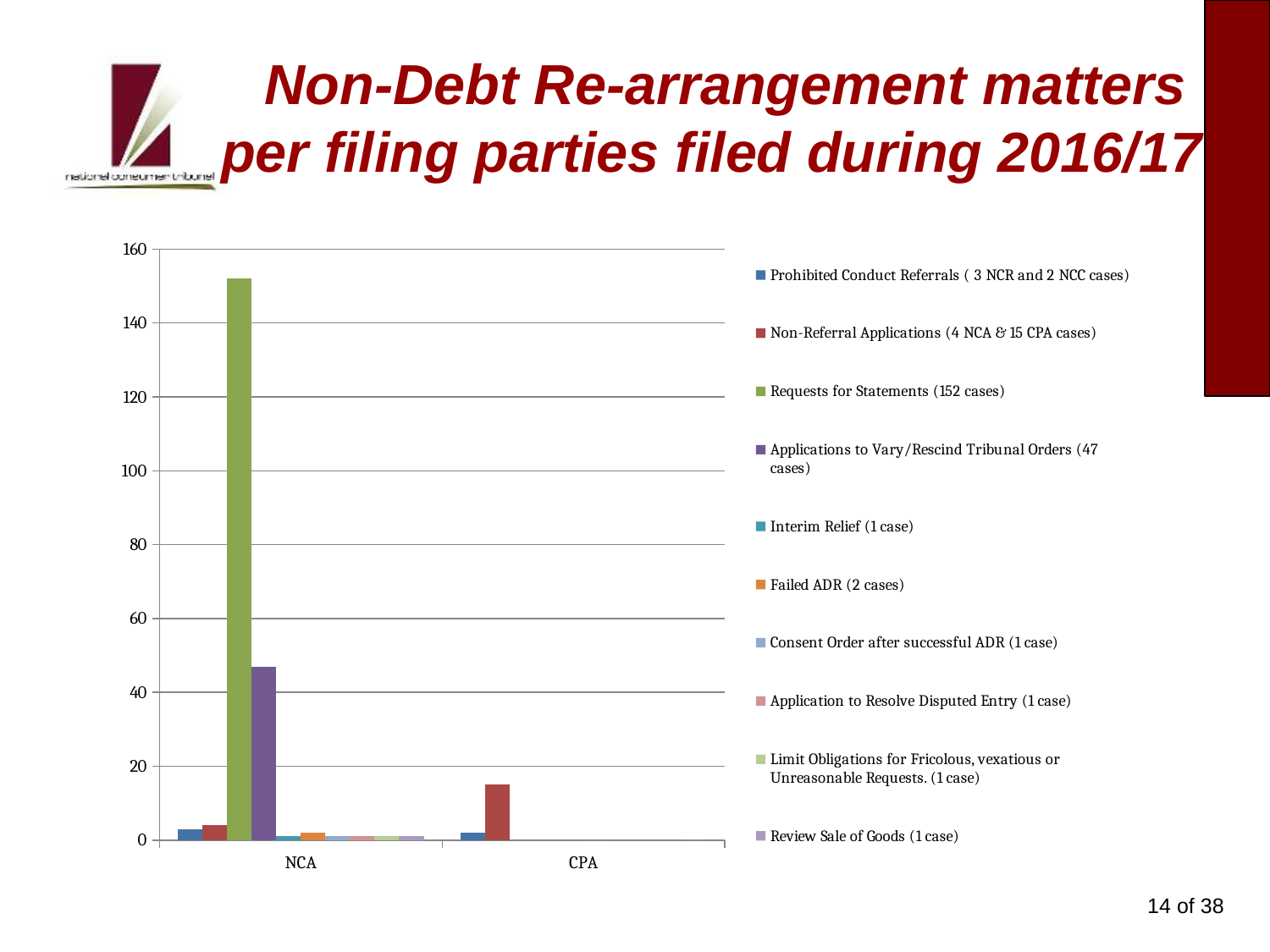
According to the legend, how many CPA cases are there for Non-Referral Applications? 15 What is the difference between the number of Requests for Statements cases (152) and Applications to Vary/Rescind Tribunal Orders cases (47)? 105 How many categories are shown on the x axis of the chart? 2 Is the CPA value for Non-Referral Applications greater or less than 20? less According to the legend, how many cases are there for Requests for Statements? 152 Is the NCA value for Applications to Vary/Rescind Tribunal Orders greater or less than 60? less What kind of chart is shown on the slide? bar chart Which series has the tallest bar in the chart? Requests for Statements For Non-Referral Applications, which filing party has the larger value, NCA or CPA? CPA Is the NCA value for Requests for Statements greater or less than 140? greater What colour represents Requests for Statements in the chart's legend? green How many series does the chart's legend list? 10